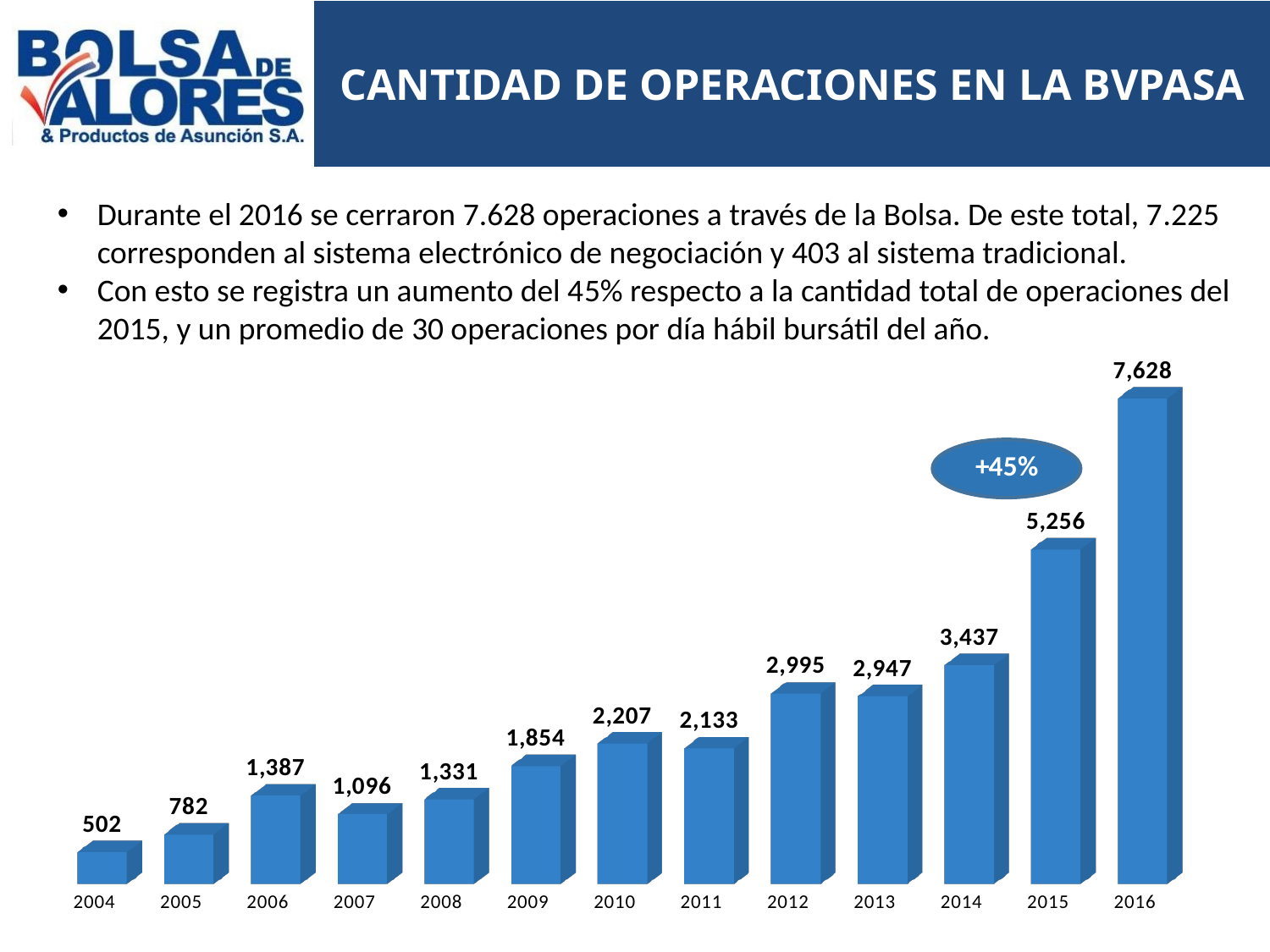
What is the value for 2004? 502 Which year has the lowest value? 2004 Which is larger, the value for 2006 or the value for 2007? 2006 What is the value for 2016? 7,628 What percentage is shown in the oval above the 2015 bar? +45% What is the difference between the values for 2016 and 2015? 2,372 What kind of chart is shown on the slide? bar chart Do the values generally rise or fall from 2004 to 2016? rise How many years are shown on the x axis? 13 What is the difference between the values for 2012 and 2013? 48 What is the value for 2011? 2,133 Which year has the highest value? 2016